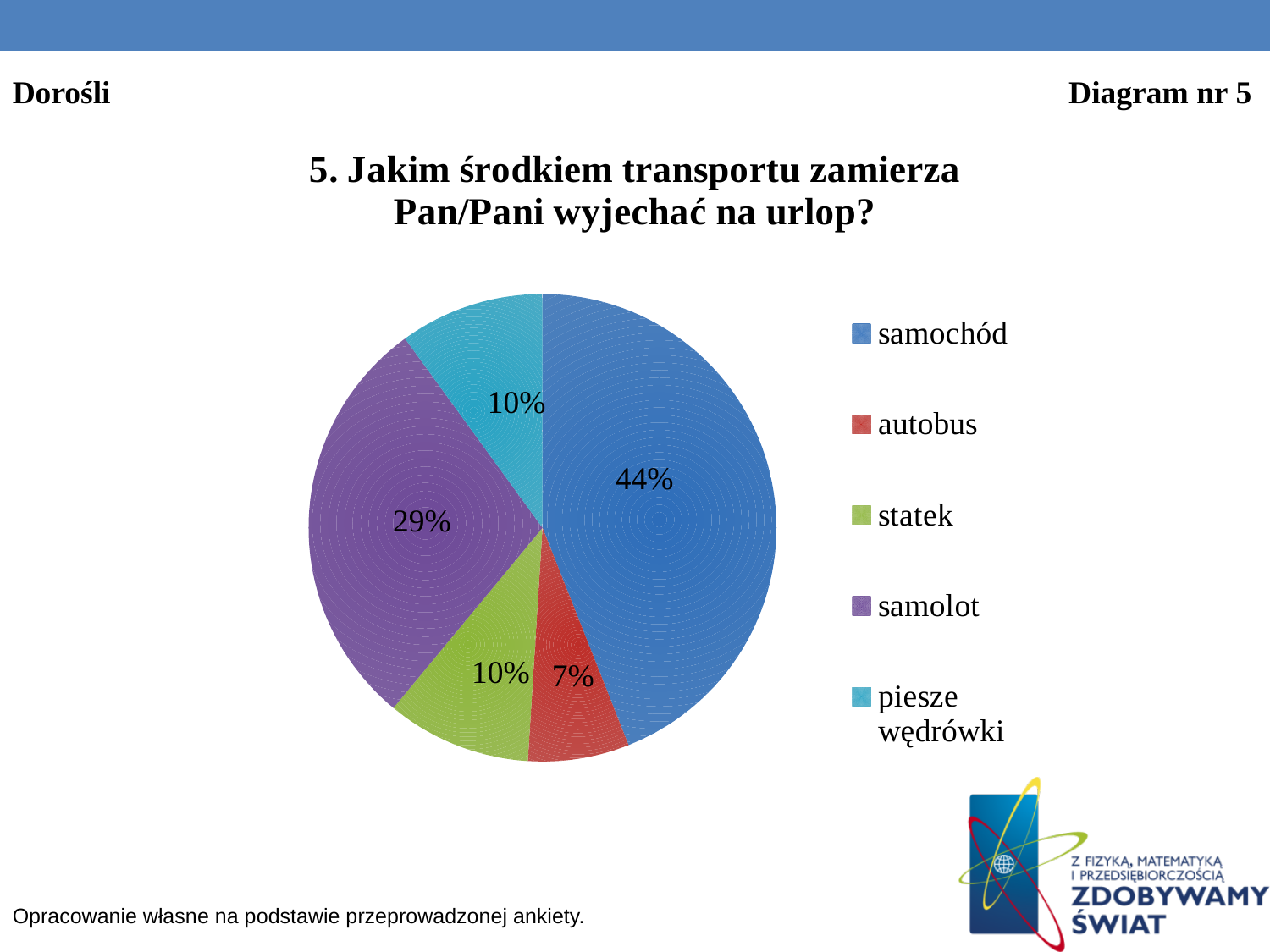
How many categories does the pie chart show? 5 What share of the pie does autobus have? 7% What share of the pie does statek have? 10% What share of the pie does samolot have? 29% What share of the pie does samochód have? 44% Which category has the largest slice of the pie? samochód Which category has the smallest slice of the pie? autobus What is the title of the chart? 5. Jakim środkiem transportu zamierza Pan/Pani wyjechać na urlop? What is the combined share of statek and piesze wędrówki? 20% What is the difference in percentage points between samochód and samolot? 15 What kind of chart is shown on the slide? pie chart Which is larger, the share for samolot or the share for statek? samolot